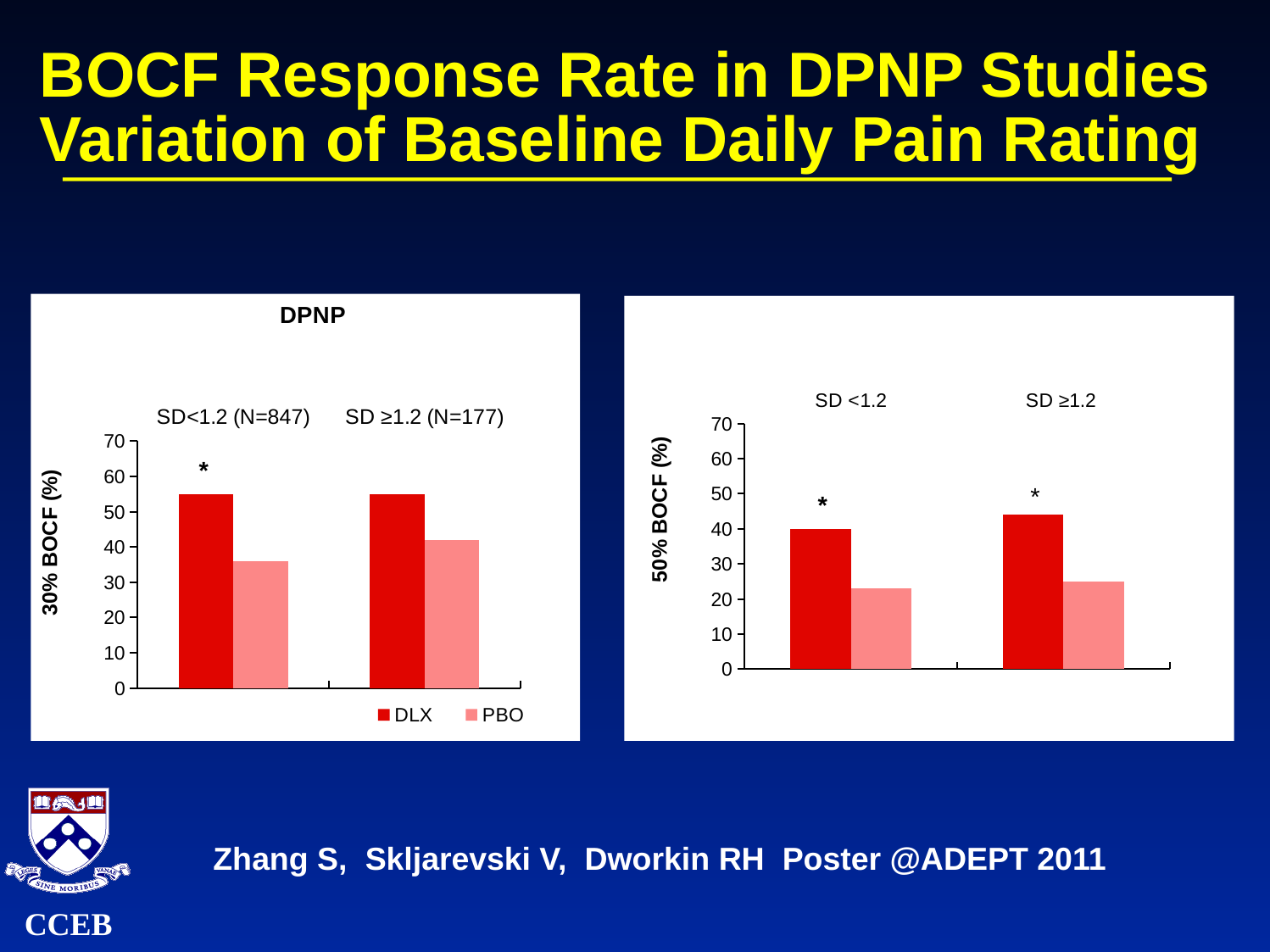
In the left chart titled DPNP, how many series does the legend list? 2 In the left chart titled DPNP, is the PBO value for SD ≥1.2 (N=177) greater or less than 50? less In the left chart titled DPNP, is the PBO value for SD<1.2 (N=847) greater or less than 40? less In the right chart, which bar is taller for SD ≥1.2, the dark red (DLX) bar or the light red (PBO) bar? dark red (DLX) In the left chart titled DPNP, how many categories are shown on the x axis? 2 In the right chart, is the PBO (light red) value for SD <1.2 greater or less than 30? less What kind of chart is the left chart titled DPNP? bar chart In the left chart titled DPNP, which is larger for SD<1.2 (N=847), DLX or PBO? DLX What is the y-axis title of the right chart? 50% BOCF (%)